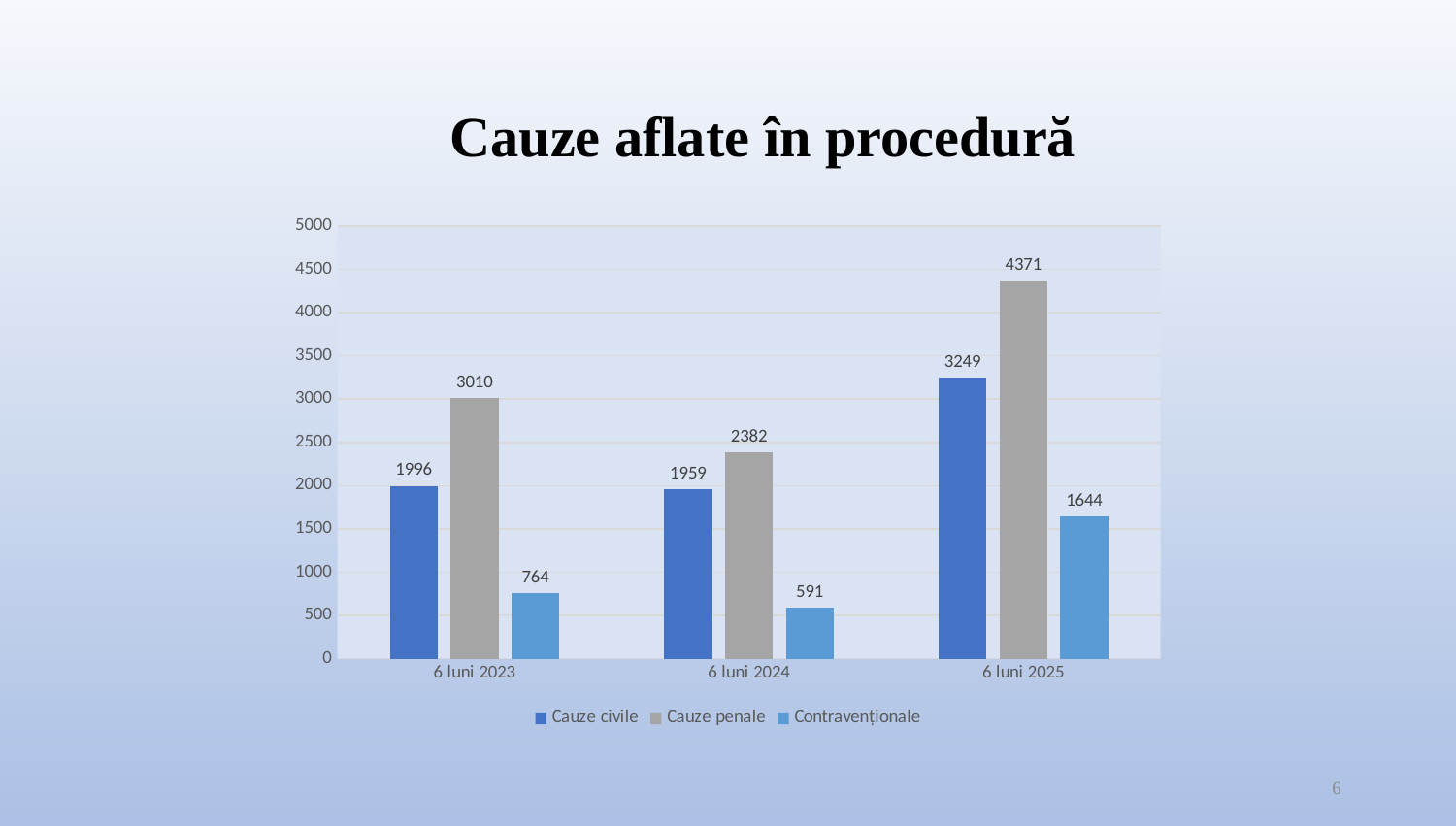
What is the value for Cauze civile in 6 luni 2023? 1996 Which is larger: Cauze civile in 6 luni 2023 or Cauze civile in 6 luni 2024? Cauze civile in 6 luni 2023 What kind of chart is shown on the slide? Bar chart What is the difference between Cauze penale in 6 luni 2025 and Cauze penale in 6 luni 2024? 1989 What is the value for Cauze penale in 6 luni 2025? 4371 Do the values for Cauze penale rise or fall from 6 luni 2024 to 6 luni 2025? Rise In which period is the value for Cauze civile highest? 6 luni 2025 What is the value for Contravenționale in 6 luni 2024? 591 How many periods are shown on the x axis? 3 In which period is the value for Contravenționale lowest? 6 luni 2024 How many series does the legend list? 3 What is the title of the chart? Cauze aflate în procedură